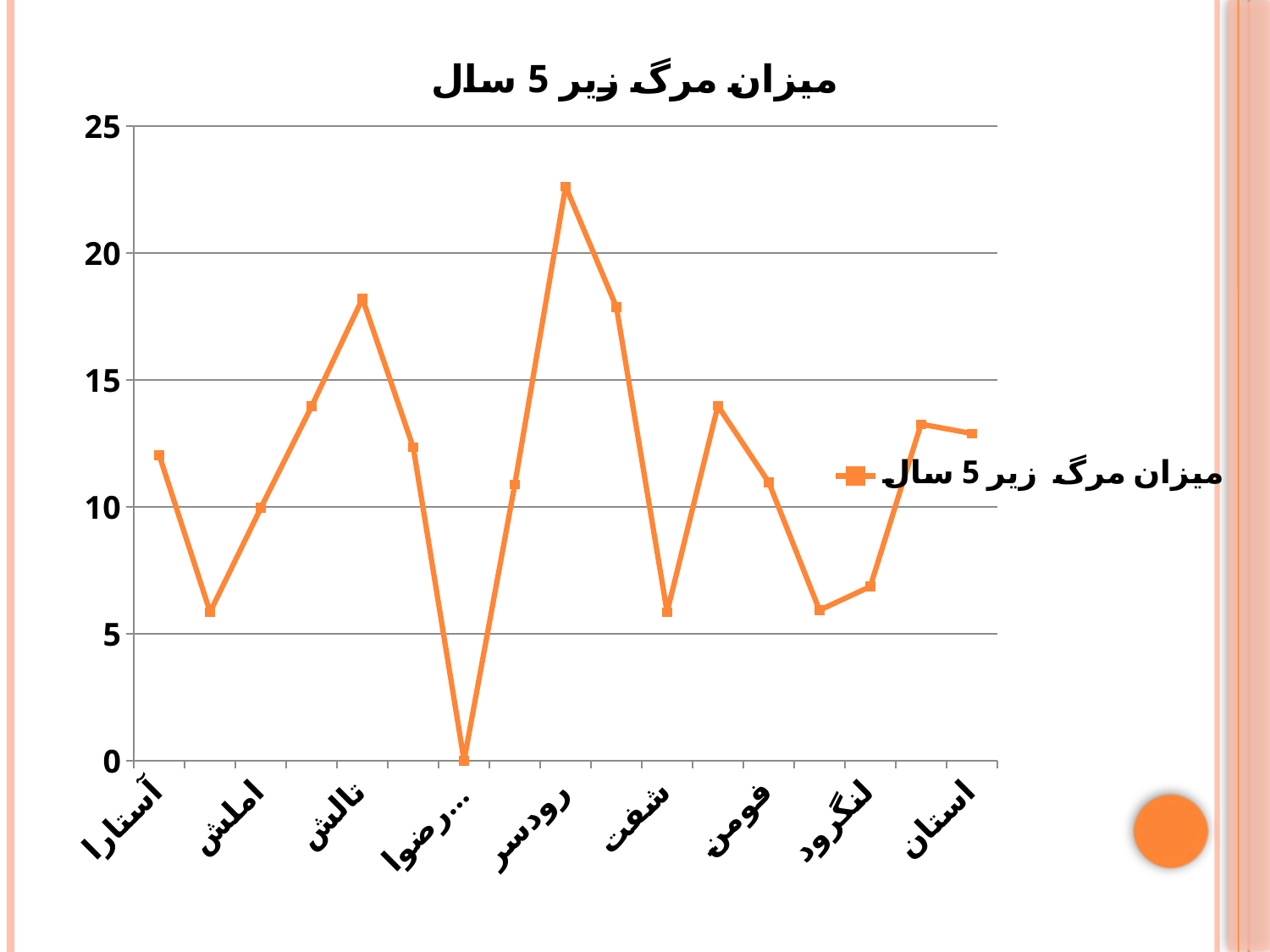
Is the value for آستارا greater or less than 10? greater What kind of chart is shown on the slide? line chart What is the title of the chart? میزان مرگ زیر 5 سال Which has the larger value, آستارا or لنگرود? آستارا How many series does the legend list? 1 Is the value for استان greater or less than 10? greater Is the value for رودسر greater or less than 20? greater Which has the larger value, رودسر or تالش? رودسر Which labeled category has the highest value? رودسر